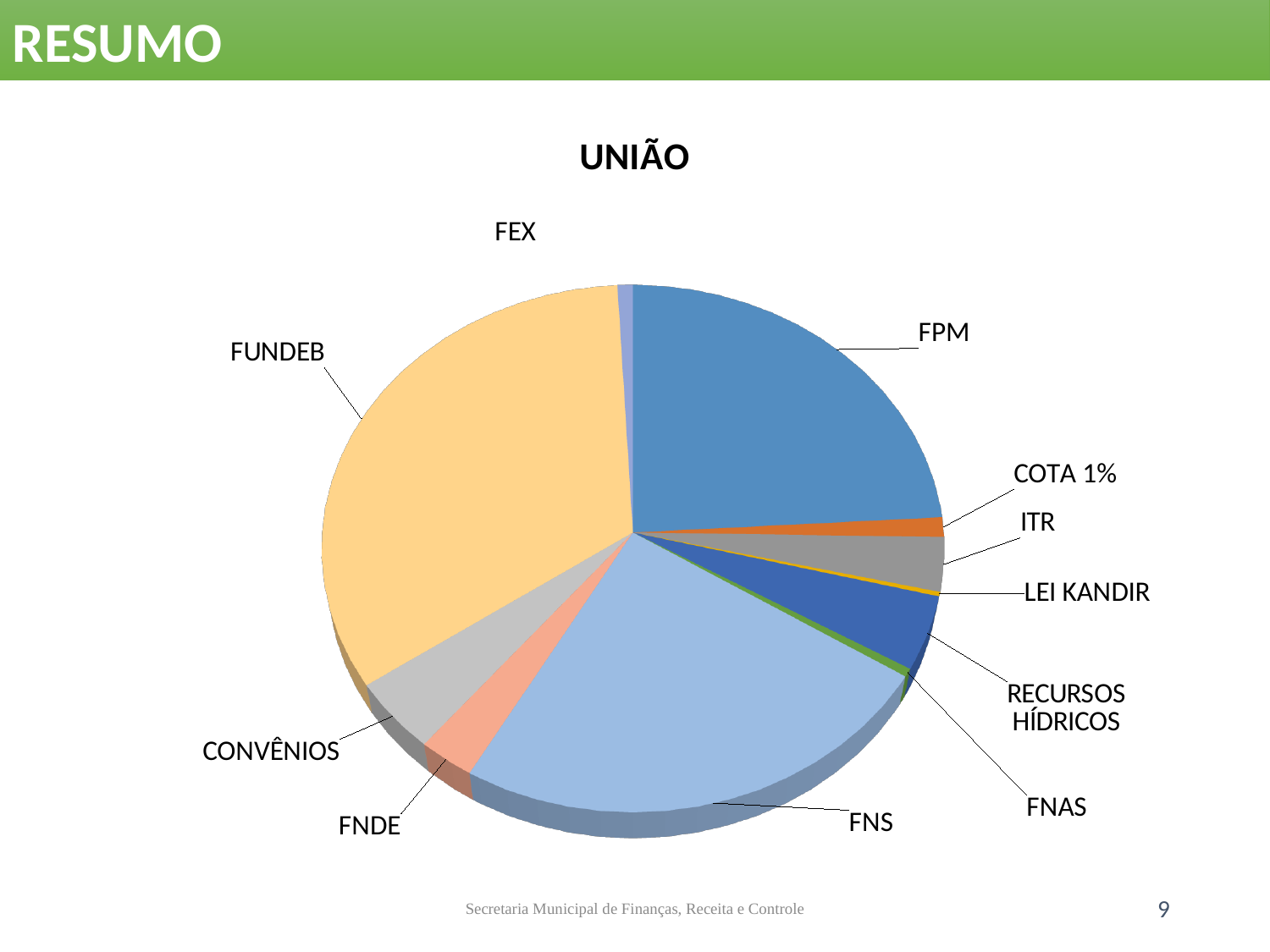
How many slices does the pie chart have? 11 Which category has the largest slice of the pie? FUNDEB Which slice is larger, FNS or FNDE? FNS Which slice is larger, CONVÊNIOS or FEX? CONVÊNIOS What is the title of the chart? UNIÃO What colour is the FUNDEB slice? yellow What kind of chart is shown on the slide? pie chart Which slice is larger, ITR or LEI KANDIR? ITR